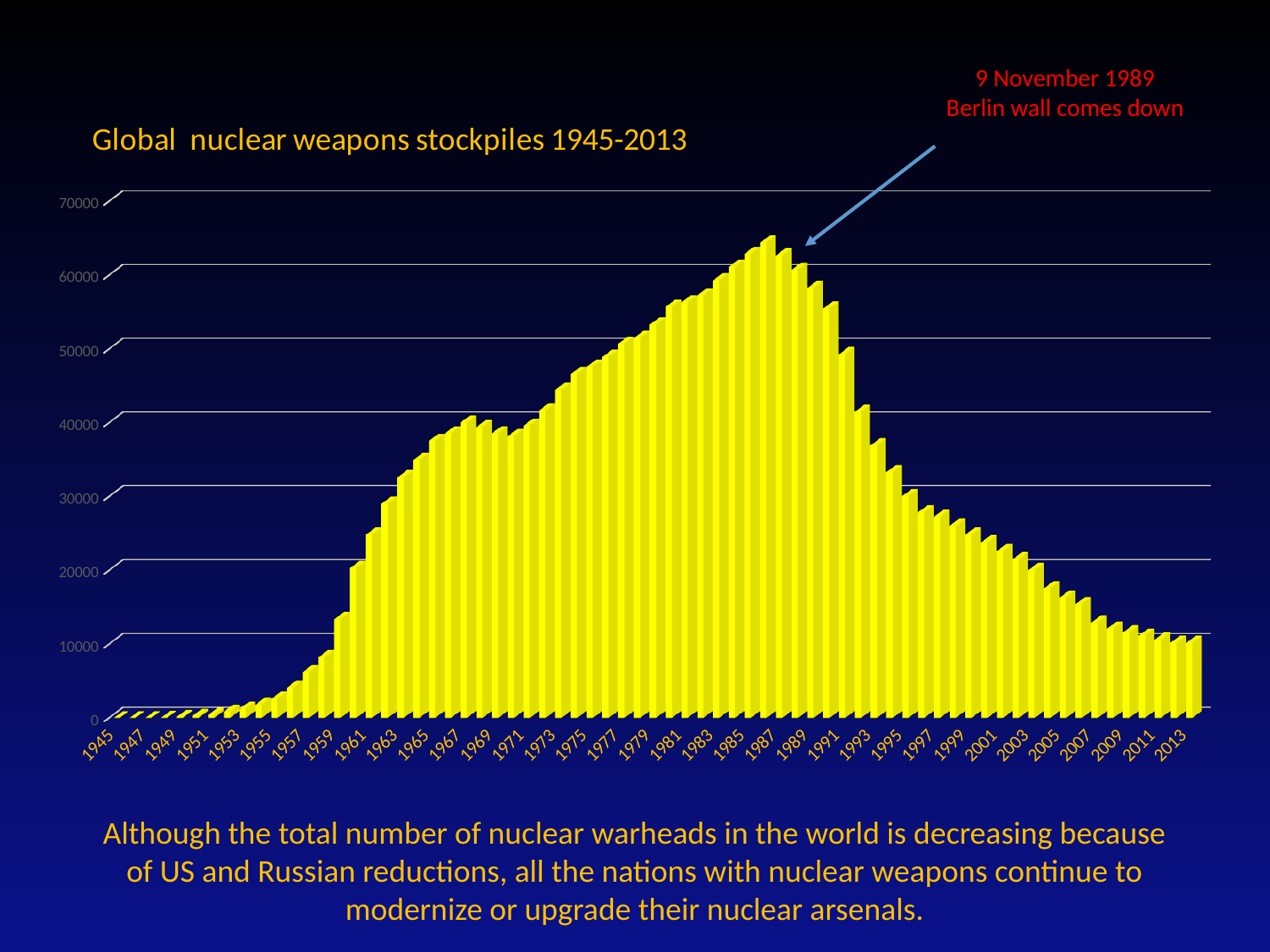
What kind of chart is shown on the slide? Bar chart Is the value for 1965 greater or less than 30000? greater Do the values rise or fall along the x axis from 1991 to 2013? fall Which year has the larger value, 1957 or 2011? 2011 Is the value for 1955 greater or less than 10000? less What is the title of the chart? Global nuclear weapons stockpiles 1945-2013 What event does the red annotation with the arrow mark on the chart? 9 November 1989, Berlin wall comes down Which year has the larger value, 1965 or 2005? 1965 Is the value for 2001 greater or less than 20000? greater In which decade does the global stockpile reach its peak? 1980s